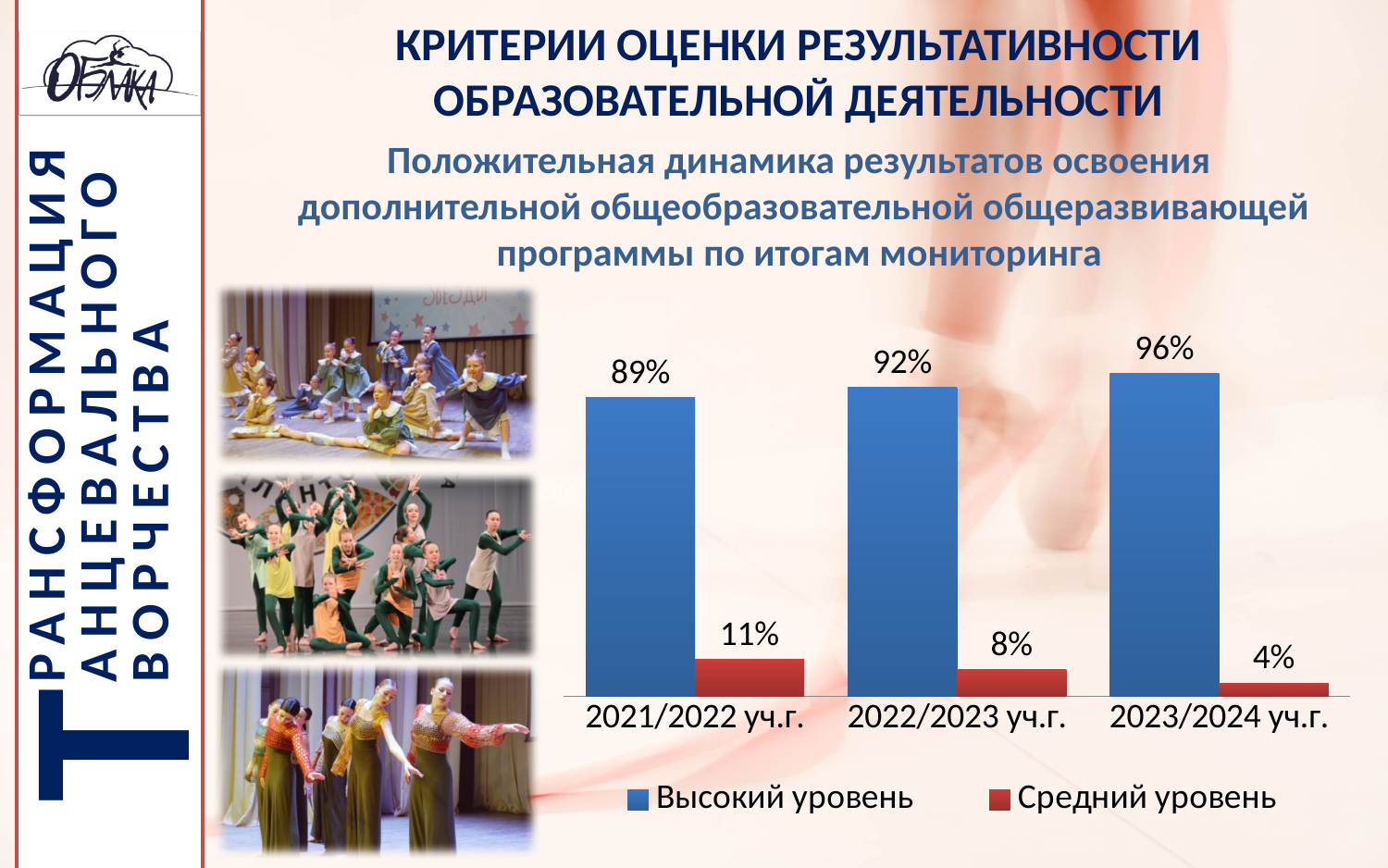
Which colour represents Средний уровень in the legend? Red Which is larger: Средний уровень in 2021/2022 уч.г. or in 2022/2023 уч.г.? 2021/2022 уч.г. What is the value for Высокий уровень in 2022/2023 уч.г.? 92% What is the value for Средний уровень in 2023/2024 уч.г.? 4% Does Высокий уровень rise or fall across the academic years? Rises How many series does the legend list? 2 How many academic years are shown on the x axis? 3 What kind of chart is shown? Bar chart What is the value for Высокий уровень in 2021/2022 уч.г.? 89% In which academic year is Высокий уровень highest? 2023/2024 уч.г. What is the difference between Высокий уровень in 2023/2024 уч.г. and in 2021/2022 уч.г.? 7% In which academic year is Средний уровень lowest? 2023/2024 уч.г.